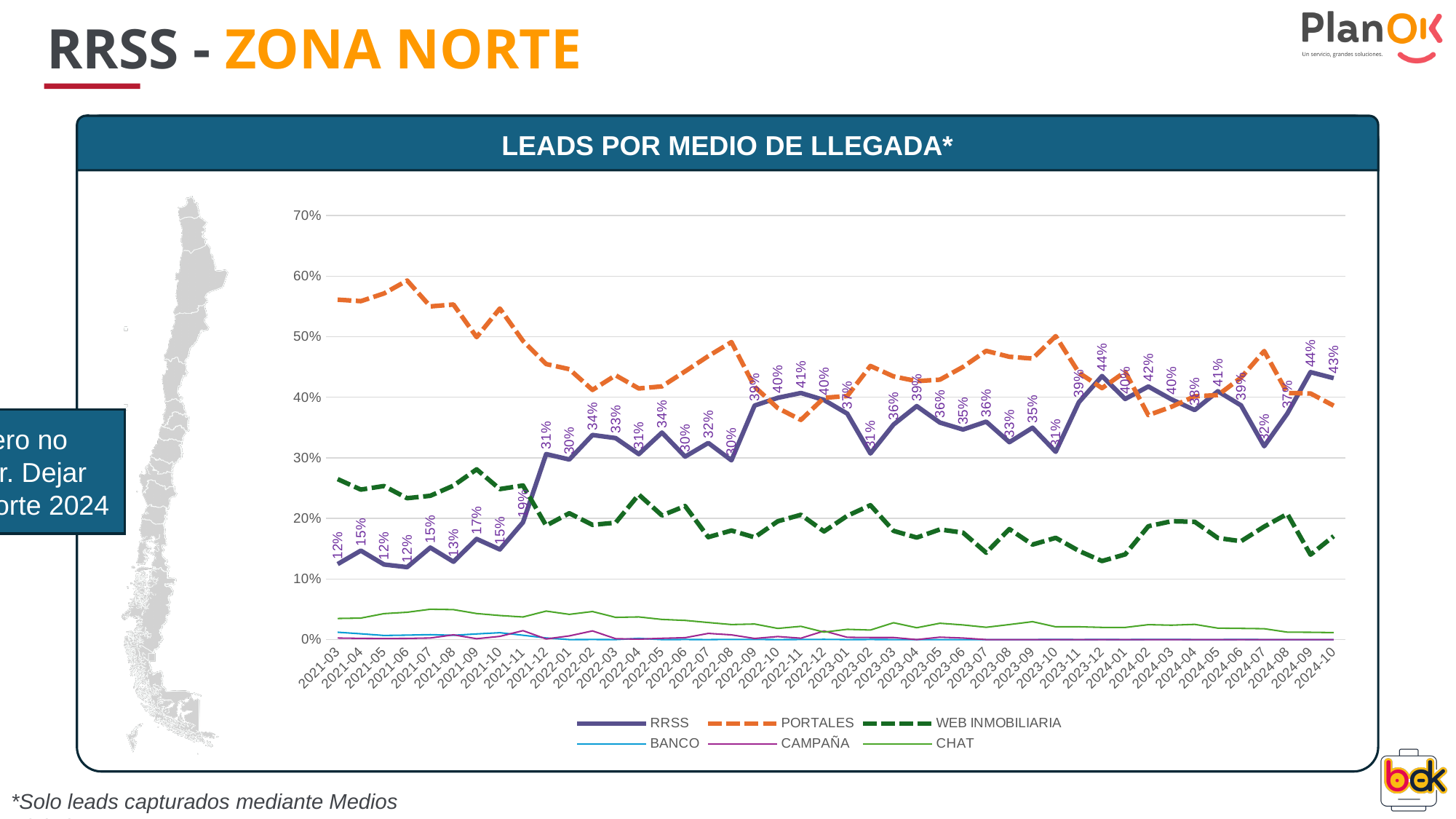
What type of chart is shown under the title 'LEADS POR MEDIO DE LLEGADA*'? Line chart What is the RRSS value for 2022-11? 41% Is the PORTALES value for 2021-06 greater or less than 50%? greater How many series does the legend of the chart list? 6 By how many percentage points did the RRSS value change from 2021-11 to 2021-12? 12 percentage points Is the WEB INMOBILIARIA value for 2024-07 greater or less than 30%? less What is the RRSS value for 2024-10? 43% What is the highest RRSS value shown on the chart? 44% Overall, does the RRSS line rise or fall from 2021-03 to 2024-10? Rise What is the lowest RRSS value shown on the chart? 12% At 2021-03, which series has the larger value, RRSS or PORTALES? PORTALES What is the RRSS value for 2021-12? 31%